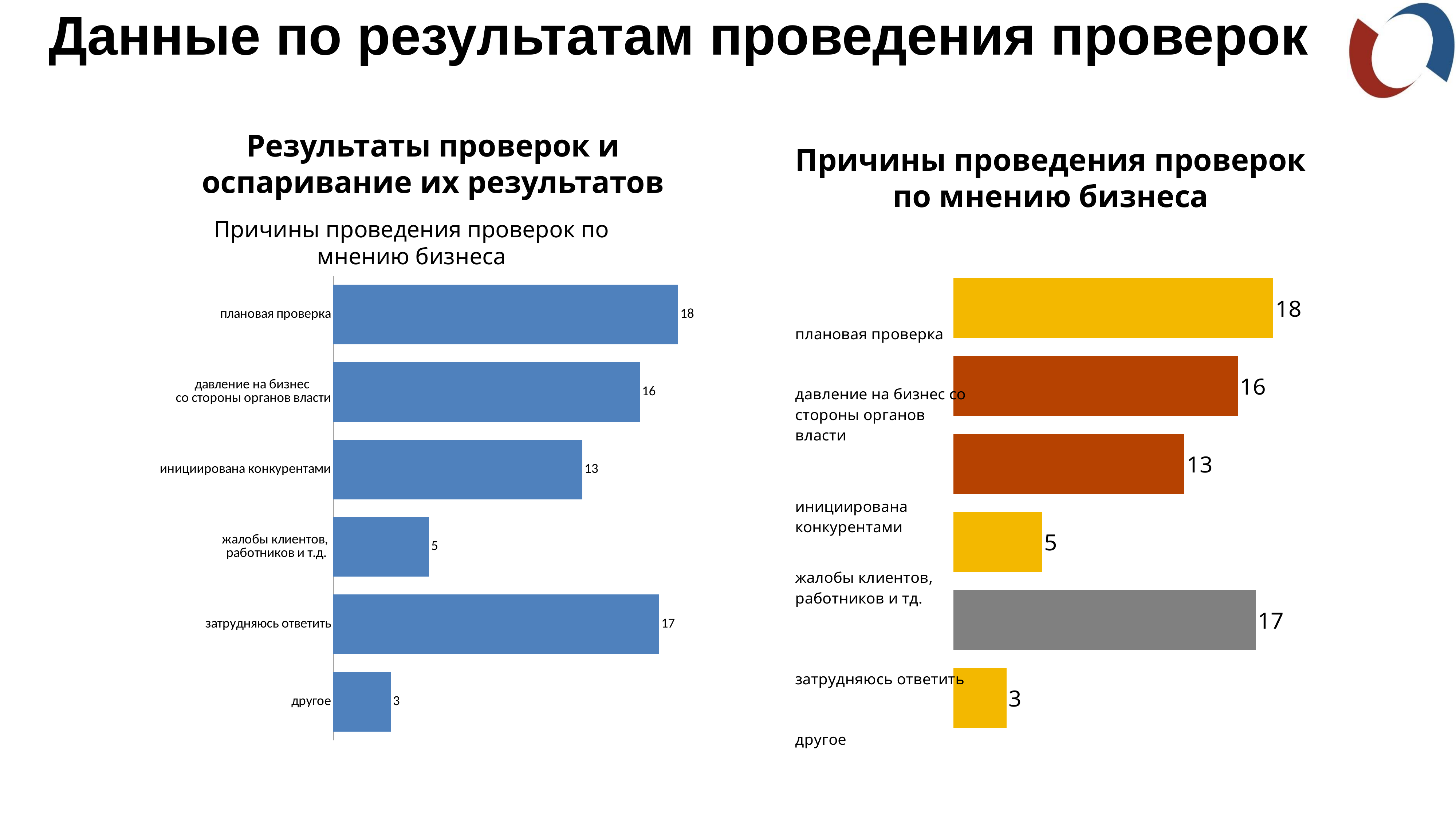
On the right chart, what colour is the bar for 'затрудняюсь ответить'? grey On the left chart, what is the value for 'затрудняюсь ответить'? 17 On the left chart, which category has the highest value? плановая проверка On the right chart, what is the value for 'инициирована конкурентами'? 13 On the right chart, which category has the lowest value? другое How many categories does the right chart show? 6 On the left chart, what is the difference between 'плановая проверка' and 'давление на бизнес со стороны органов власти'? 2 On the left chart, what is the value for 'плановая проверка'? 18 On the left chart, which is larger: 'инициирована конкурентами' or 'жалобы клиентов, работников и т.д.'? инициирована конкурентами On the right chart, what is the difference between 'затрудняюсь ответить' and 'жалобы клиентов, работников и тд.'? 12 On the right chart, what is the value for 'другое'? 3 What type of chart is the left chart? bar chart